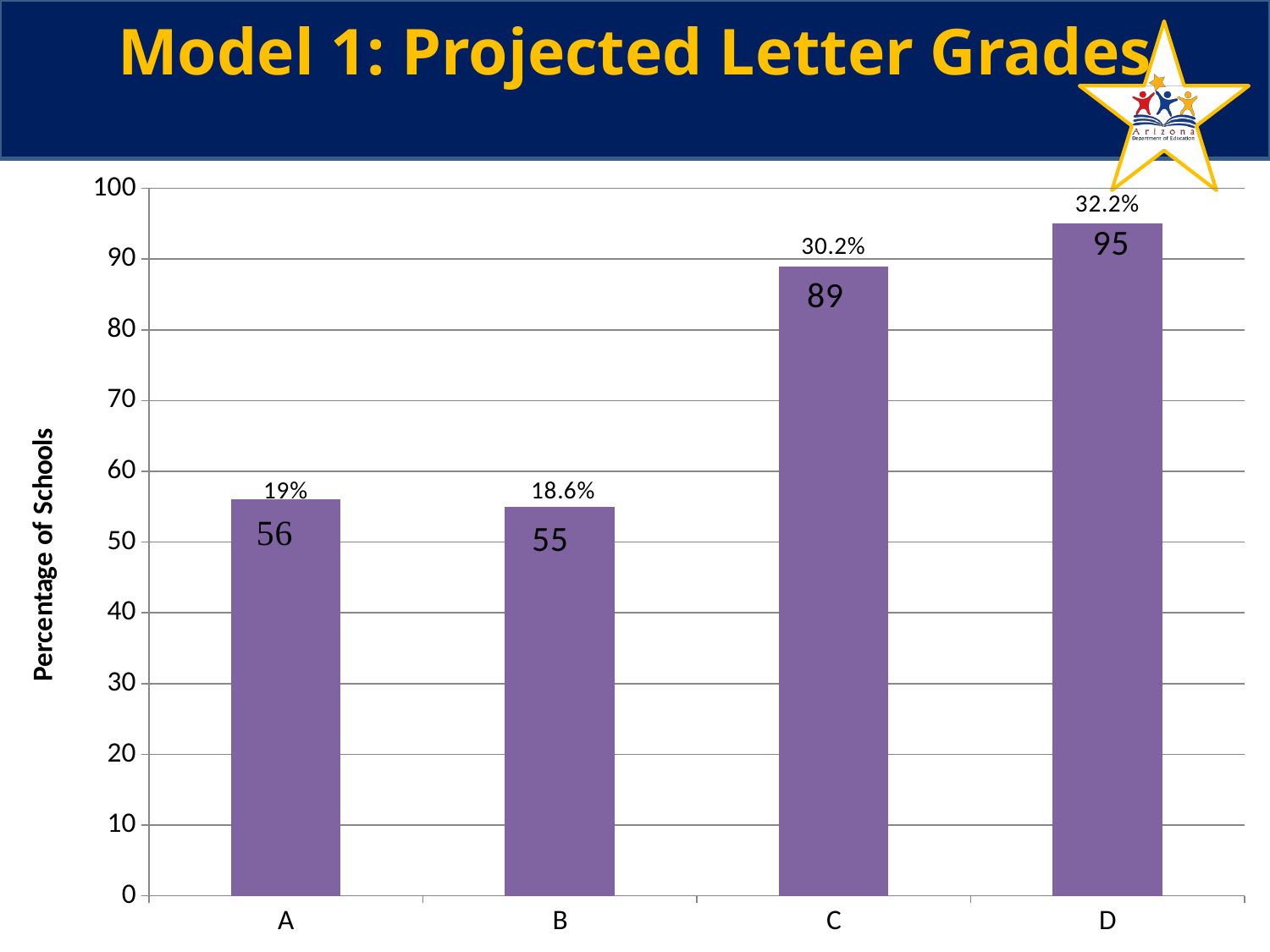
What is the difference between the values for A and B? 1 What is the value shown on the bar for letter grade D? 95 How many letter grade categories are shown on the x axis? 4 Which is larger, the value for C or the value for A? C Which letter grade has the lowest bar? B What percentage label appears above the bar for letter grade C? 30.2% Which letter grade has the highest bar? D What is the difference between the values for D and C? 6 What is the value shown on the bar for letter grade A? 56 What kind of chart is shown on the slide? Bar chart What is the label on the vertical axis? Percentage of Schools What percentage label appears above the bar for letter grade B? 18.6%